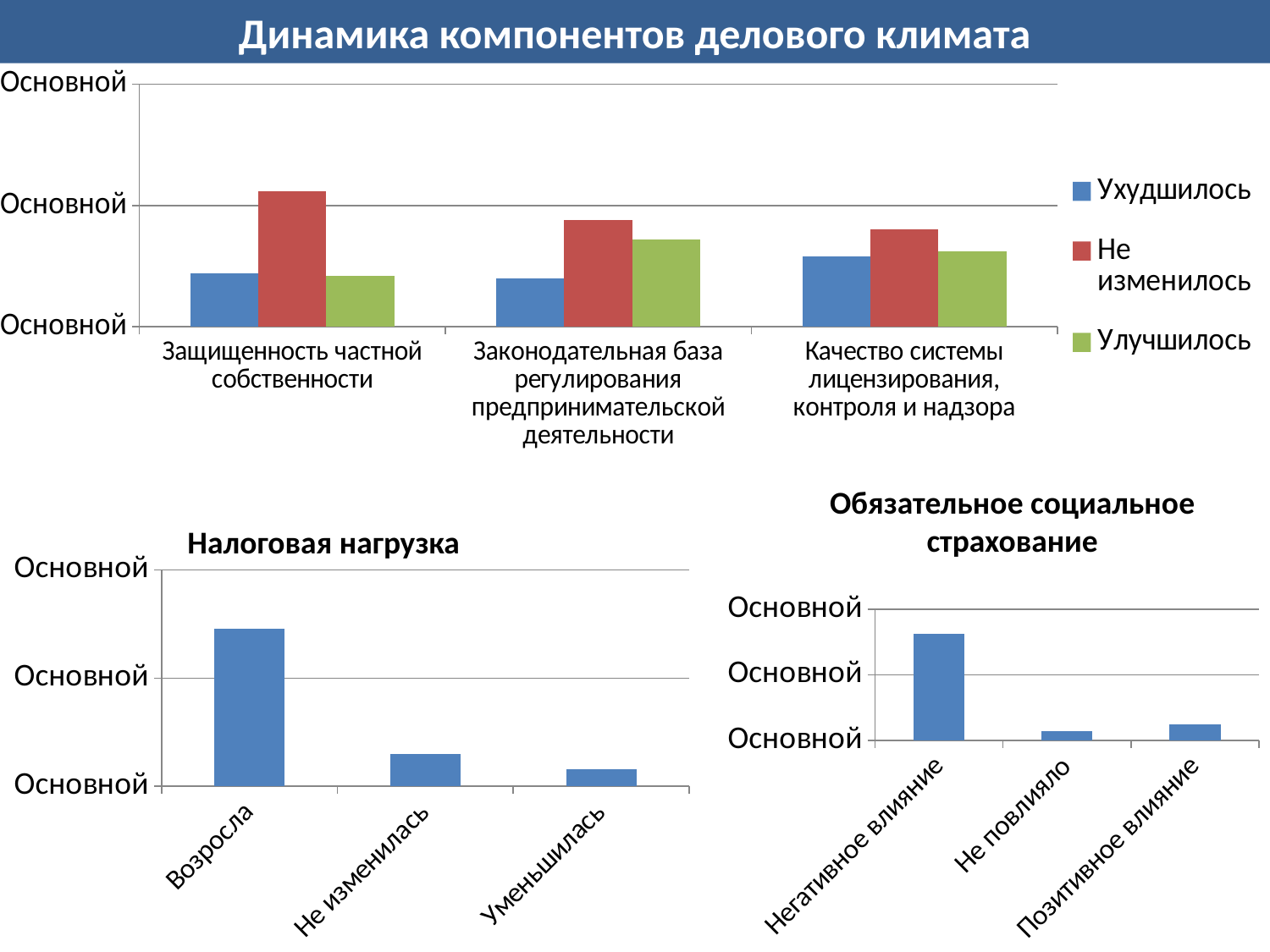
In the top chart, what are the legend entries? Ухудшилось, Не изменилось, Улучшилось What kind of chart is Налоговая нагрузка? Bar chart In the top chart, how many series does the legend list? 3 In the top chart, how many categories are shown on the x axis? 3 In the Обязательное социальное страхование chart, which is larger: Не повлияло or Позитивное влияние? Позитивное влияние In the top chart, which category has the tallest Не изменилось bar? Защищенность частной собственности In the Налоговая нагрузка chart, which category has the lowest value? Уменьшилась In the Налоговая нагрузка chart, which category has the highest value? Возросла In the top chart, which series has the highest bar for Защищенность частной собственности? Не изменилось How many charts are on the slide? 3 In the top chart, for Законодательная база регулирования предпринимательской деятельности, which is larger: Ухудшилось or Улучшилось? Улучшилось